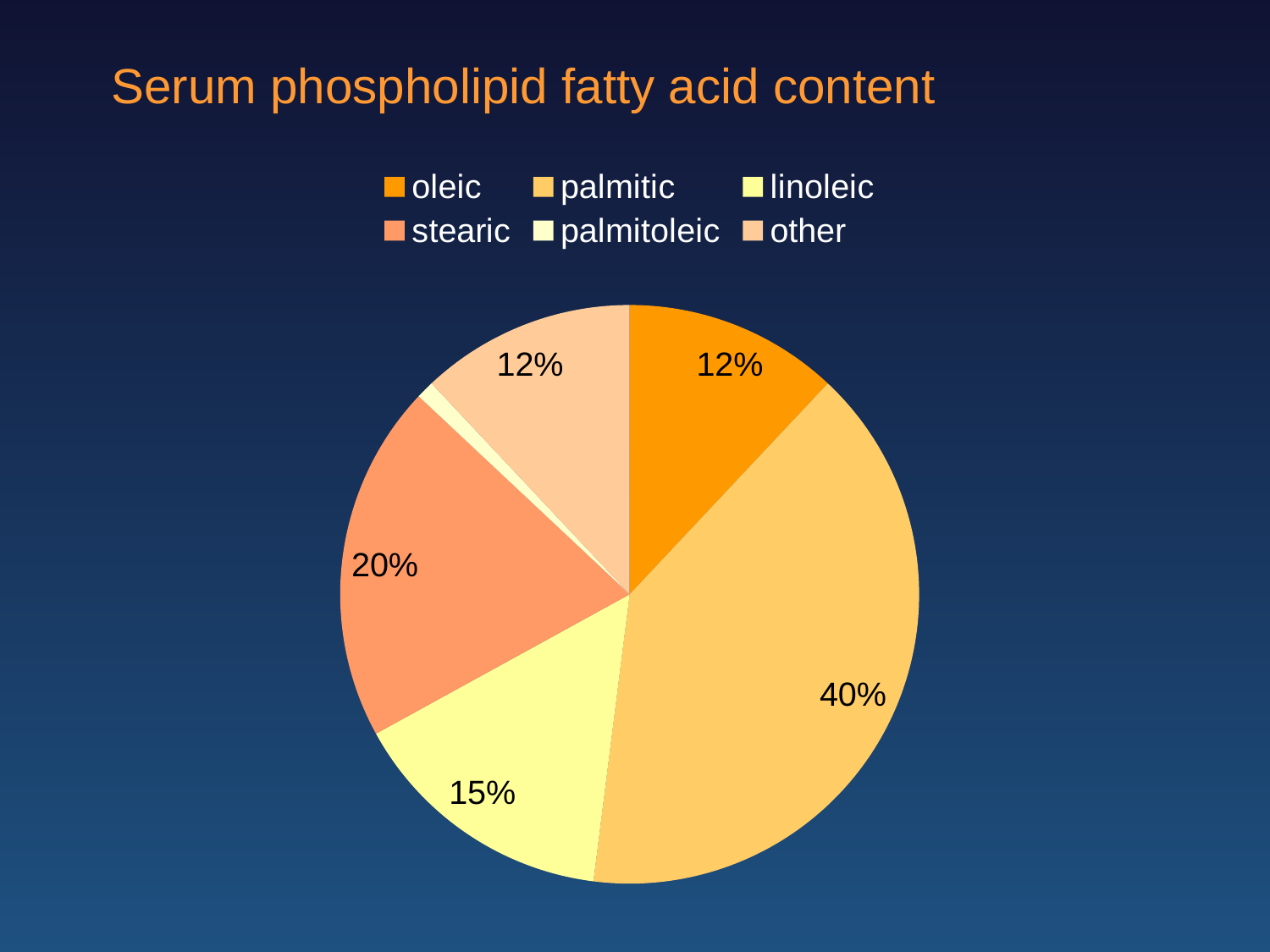
What share of the pie is linoleic? 15% What share of the pie is stearic? 20% Which category has the largest slice of the pie? palmitic What is the difference between the palmitic share and the stearic share? 20% What share of the pie is oleic? 12% Which category has the smallest slice of the pie? palmitoleic How many categories does the legend list? 6 Which is larger, the stearic share or the linoleic share? stearic What is the title of the chart? Serum phospholipid fatty acid content What kind of chart is shown on the slide? pie chart Which legend entry is shown in the darkest orange colour? oleic What share of the pie is palmitic? 40%